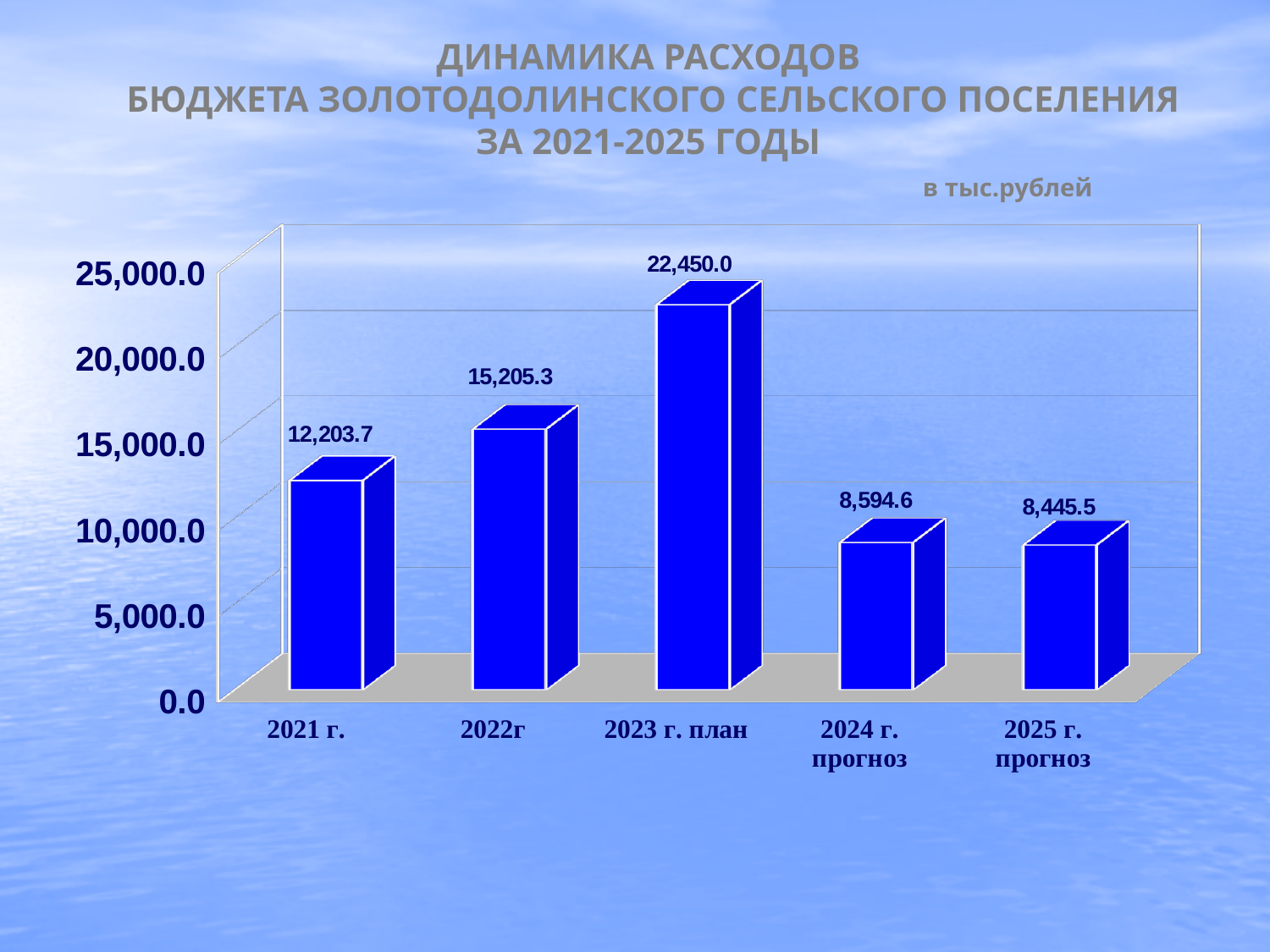
Which category has the lowest value? 2025 г. прогноз Which is larger, the value for 2021 г. or the value for 2024 г. прогноз? 2021 г. What is the value for 2025 г. прогноз? 8,445.5 What is the value for 2021 г.? 12,203.7 In what units are the values on the chart expressed? тыс.рублей What is the value for 2023 г. план? 22,450.0 What is the difference between the values for 2022г and 2021 г.? 3,001.6 What kind of chart is shown on the slide? bar chart What is the difference between the values for 2023 г. план and 2022г? 7,244.7 How many categories are shown on the x axis? 5 Which category has the highest value? 2023 г. план Is the value for 2023 г. план greater or less than 20,000.0? greater